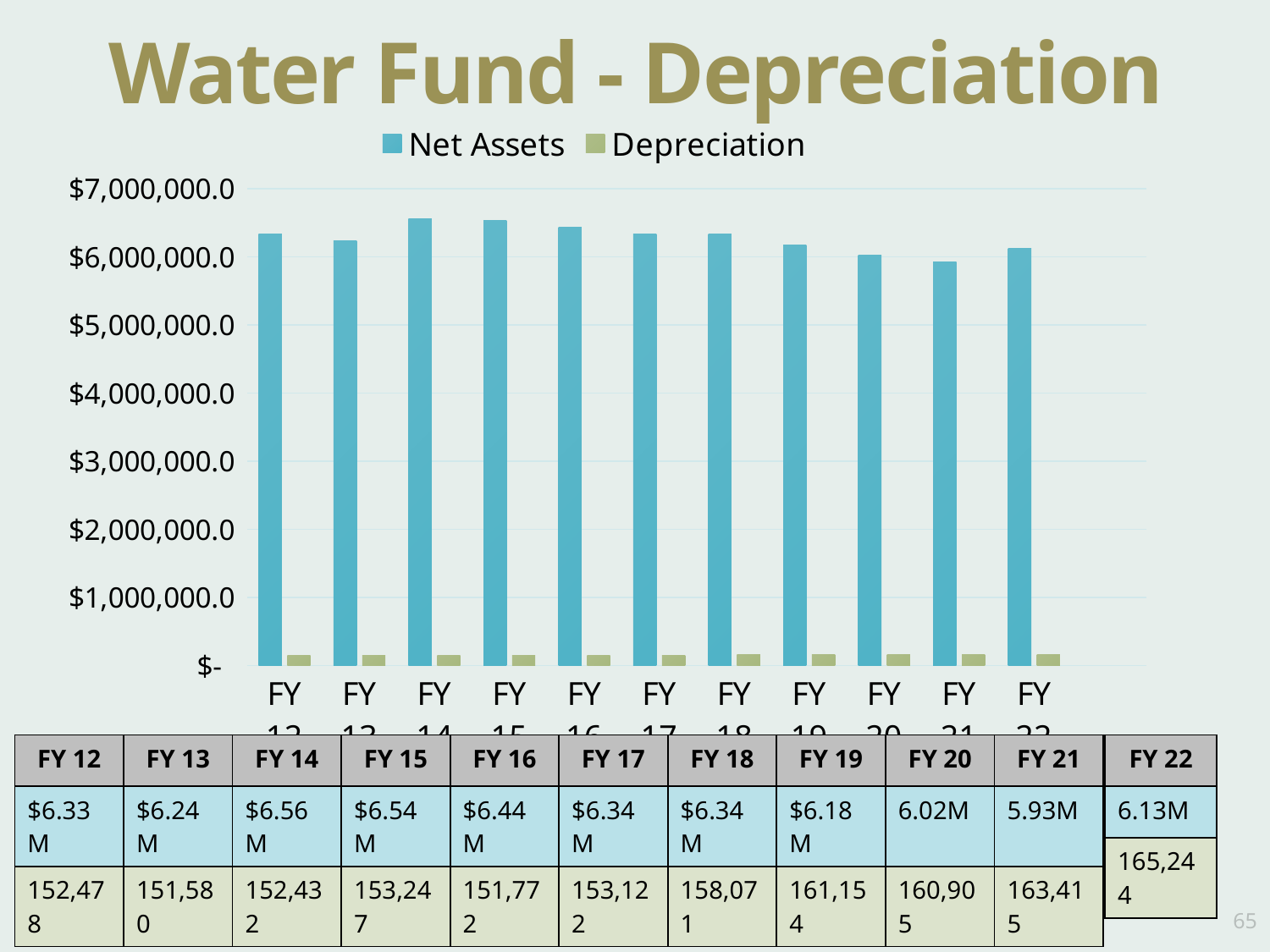
How many series does the legend list? 2 What is the Net Assets value for FY 14? $6.56M Is the Net Assets value for FY 14 greater or less than $6,000,000.0? greater What is the Depreciation value for FY 22? 165,244 What is the Net Assets value for FY 21? 5.93M What is the Depreciation value for FY 12? 152,478 Which fiscal year has the lowest Net Assets? FY 21 How many fiscal years are shown on the x axis? 11 Which fiscal year has the highest Net Assets? FY 14 Which is larger, Net Assets in FY 14 or Net Assets in FY 21? FY 14 Which fiscal year has the highest Depreciation? FY 22 What is the difference in Depreciation between FY 22 and FY 12? 12,766